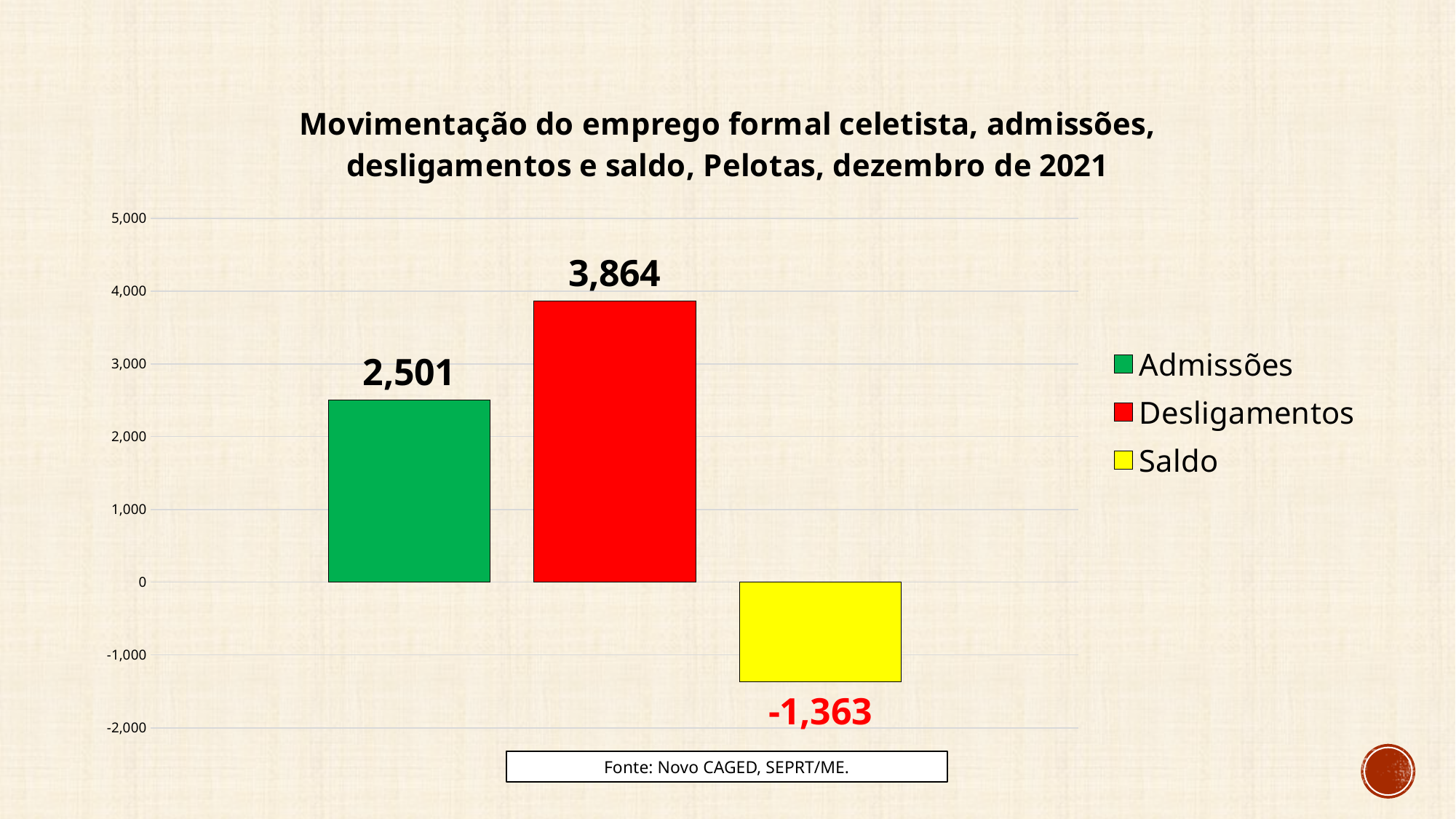
What is the difference between Desligamentos and Admissões? 1,363 Which series has the lowest value? Saldo How many bars are plotted in the chart? 3 What colour is the bar for Saldo? yellow What is the value for Saldo? -1,363 What is the value for Admissões? 2,501 What kind of chart is shown on the slide? bar chart What is the value for Desligamentos? 3,864 Is the value for Admissões greater or less than 3,000? less Which series has the highest value? Desligamentos How many series does the legend list? 3 Which is larger, Admissões or Desligamentos? Desligamentos